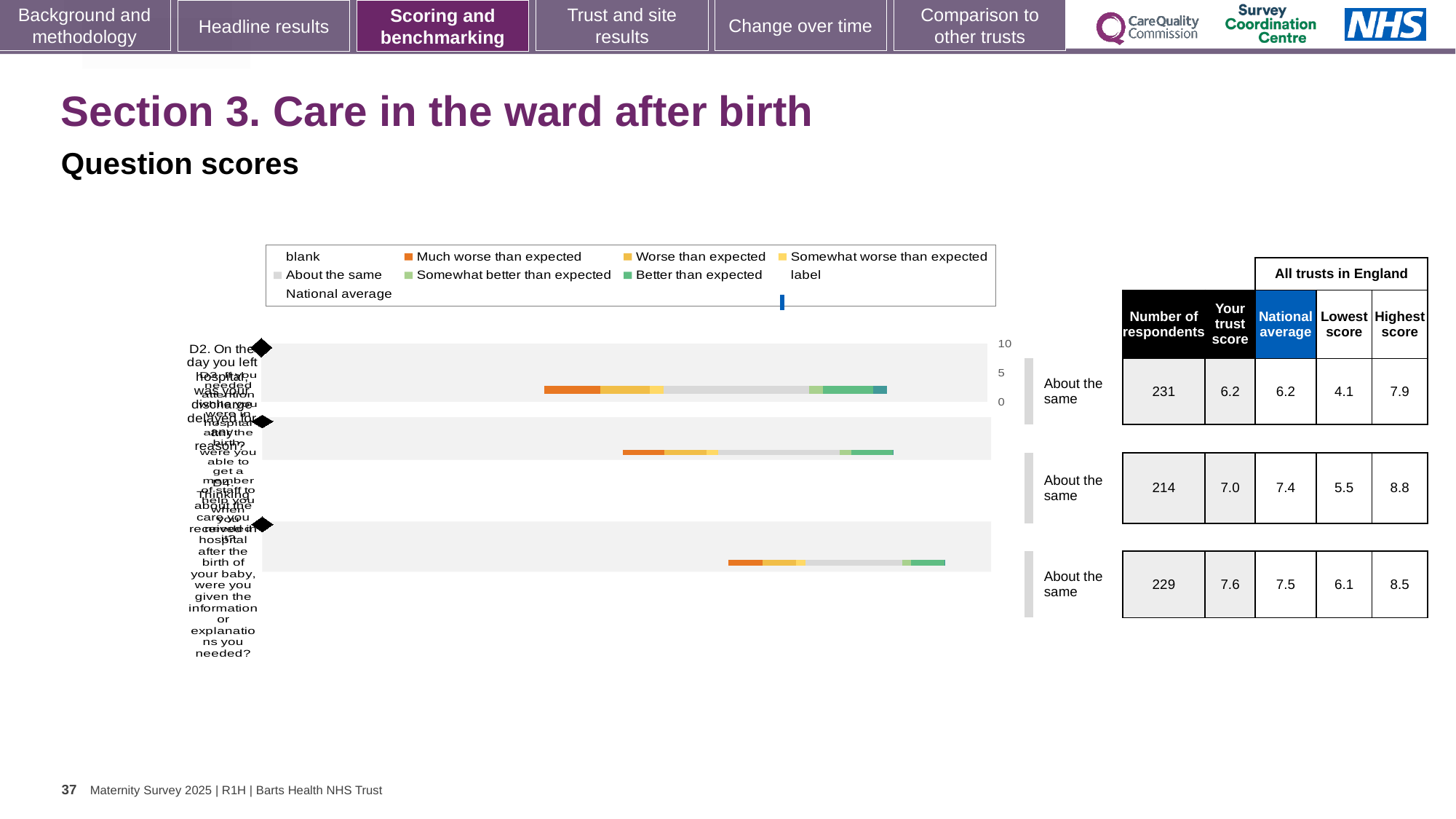
For the second row, what is the difference between the national average (7.4) and the trust score (7.0)? 0.4 How many question rows (bars) are plotted in the chart? 3 In the table beside the chart, what is the number of respondents for the third (bottom) row? 229 What kind of chart is shown on the slide? Bar chart Which row has the largest 'Highest score' value in the table beside the chart? The second row (8.8) In the table beside the chart, what is the national average for the third (bottom) row? 7.5 For the third (bottom) row, which is larger: the trust score or the national average? The trust score (7.6) In the table beside the chart, what is the number of respondents for the first (top) row? 231 What benchmark label is shown next to each of the three bars in the chart? About the same In the table beside the chart, what is the 'Your trust score' for the second row? 7.0 Which row has the smallest 'Lowest score' value in the table beside the chart? The first row (4.1) What colour does the legend use for 'Much worse than expected'? Orange